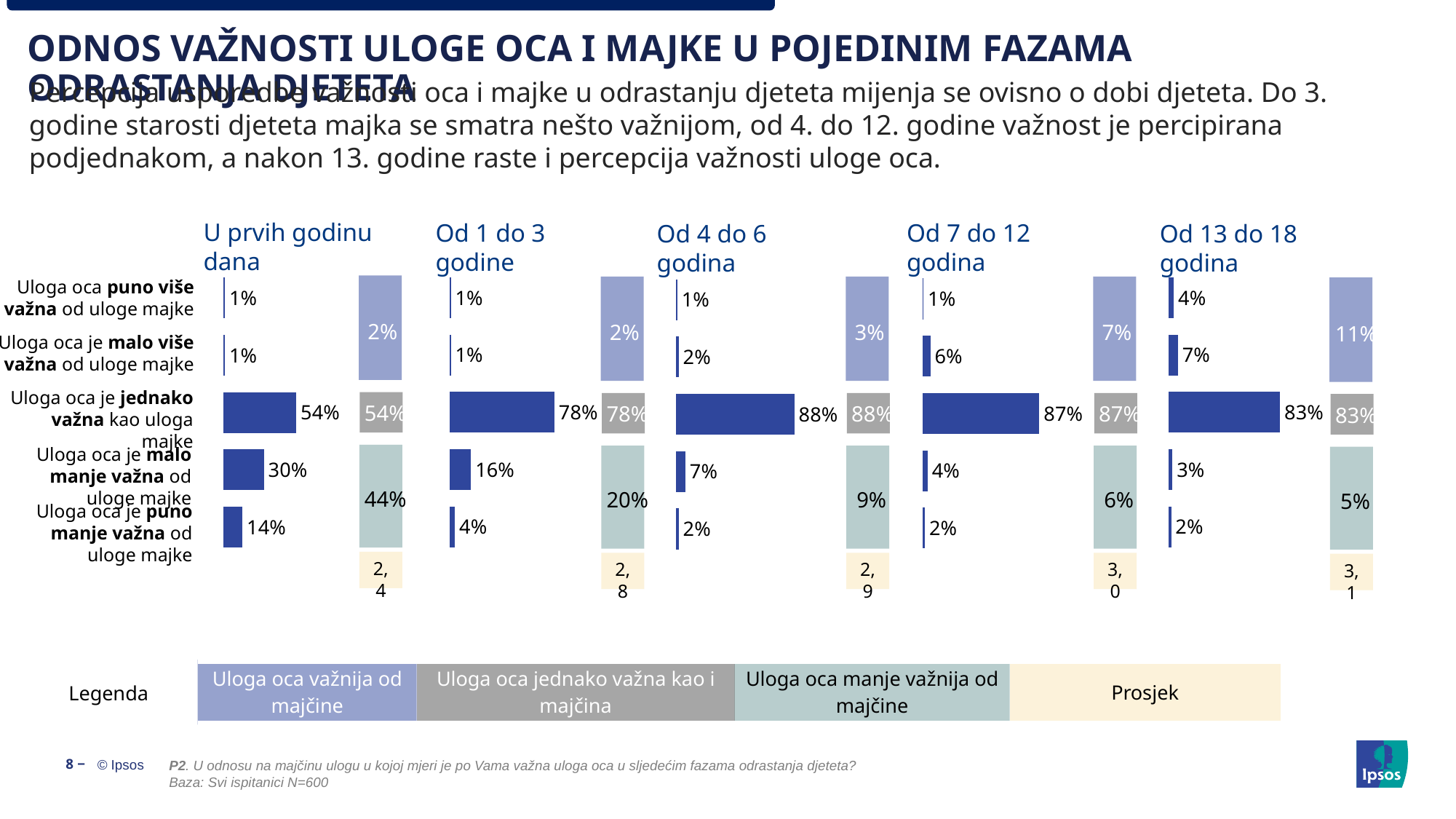
In the chart titled "Od 13 do 18 godina", what is the value for "Uloga oca je malo više važna od uloge majke"? 7% In the chart titled "Od 4 do 6 godina", which category has the highest value? Uloga oca je jednako važna kao uloga majke How many entries does the legend ("Legenda") list? 4 In the chart titled "U prvih godinu dana", what is the value for "Uloga oca je malo manje važna od uloge majke"? 30% Which is larger: the value for "Uloga oca je jednako važna kao uloga majke" in the chart "Od 4 do 6 godina" or in the chart "Od 13 do 18 godina"? Od 4 do 6 godina In the chart titled "Od 1 do 3 godine", what is the value for "Uloga oca je puno manje važna od uloge majke"? 4% In the chart titled "U prvih godinu dana", what is the difference between "Uloga oca je malo manje važna od uloge majke" and "Uloga oca je puno manje važna od uloge majke"? 16% In the chart titled "Od 7 do 12 godina", what is the difference between "Uloga oca je jednako važna kao uloga majke" and "Uloga oca je malo više važna od uloge majke"? 81% What kind of chart is used for each age phase on the slide? Bar chart In the chart titled "U prvih godinu dana", what is the value for "Uloga oca je jednako važna kao uloga majke"? 54% How many categories does each of the five bar charts show? 5 What is the "Prosjek" (average) value shown for the chart titled "Od 13 do 18 godina"? 3,1